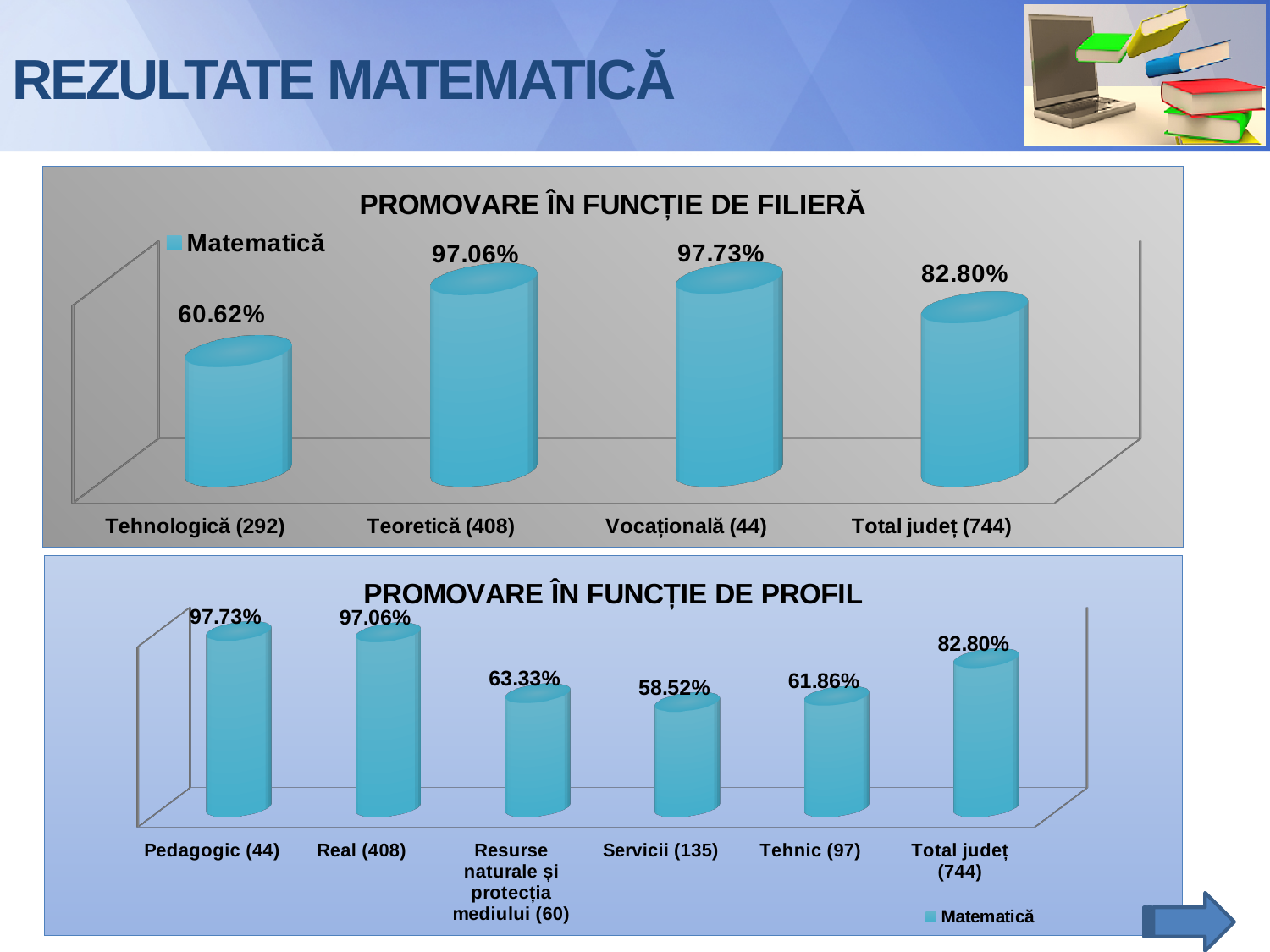
In the chart titled "PROMOVARE ÎN FUNCȚIE DE FILIERĂ", which category has the highest value? Vocațională (44) In the chart titled "PROMOVARE ÎN FUNCȚIE DE FILIERĂ", how many categories are shown? 4 In the chart titled "PROMOVARE ÎN FUNCȚIE DE PROFIL", what is the value for Servicii (135)? 58.52% In the chart titled "PROMOVARE ÎN FUNCȚIE DE FILIERĂ", what is the value for Teoretică (408)? 97.06% In the chart titled "PROMOVARE ÎN FUNCȚIE DE PROFIL", what is the value for Resurse naturale și protecția mediului (60)? 63.33% In the chart titled "PROMOVARE ÎN FUNCȚIE DE FILIERĂ", what is the difference between the values for Total județ (744) and Tehnologică (292)? 22.18% In the chart titled "PROMOVARE ÎN FUNCȚIE DE FILIERĂ", what is the value for Tehnologică (292)? 60.62% In the chart titled "PROMOVARE ÎN FUNCȚIE DE FILIERĂ", which category has the lowest value? Tehnologică (292) In the chart titled "PROMOVARE ÎN FUNCȚIE DE PROFIL", which category has the lowest value? Servicii (135) In the chart titled "PROMOVARE ÎN FUNCȚIE DE PROFIL", how many categories are shown? 6 In the chart titled "PROMOVARE ÎN FUNCȚIE DE PROFIL", which is larger, the value for Tehnic (97) or the value for Resurse naturale și protecția mediului (60)? Resurse naturale și protecția mediului (60) What kind of chart is the chart titled "PROMOVARE ÎN FUNCȚIE DE PROFIL"? Bar chart